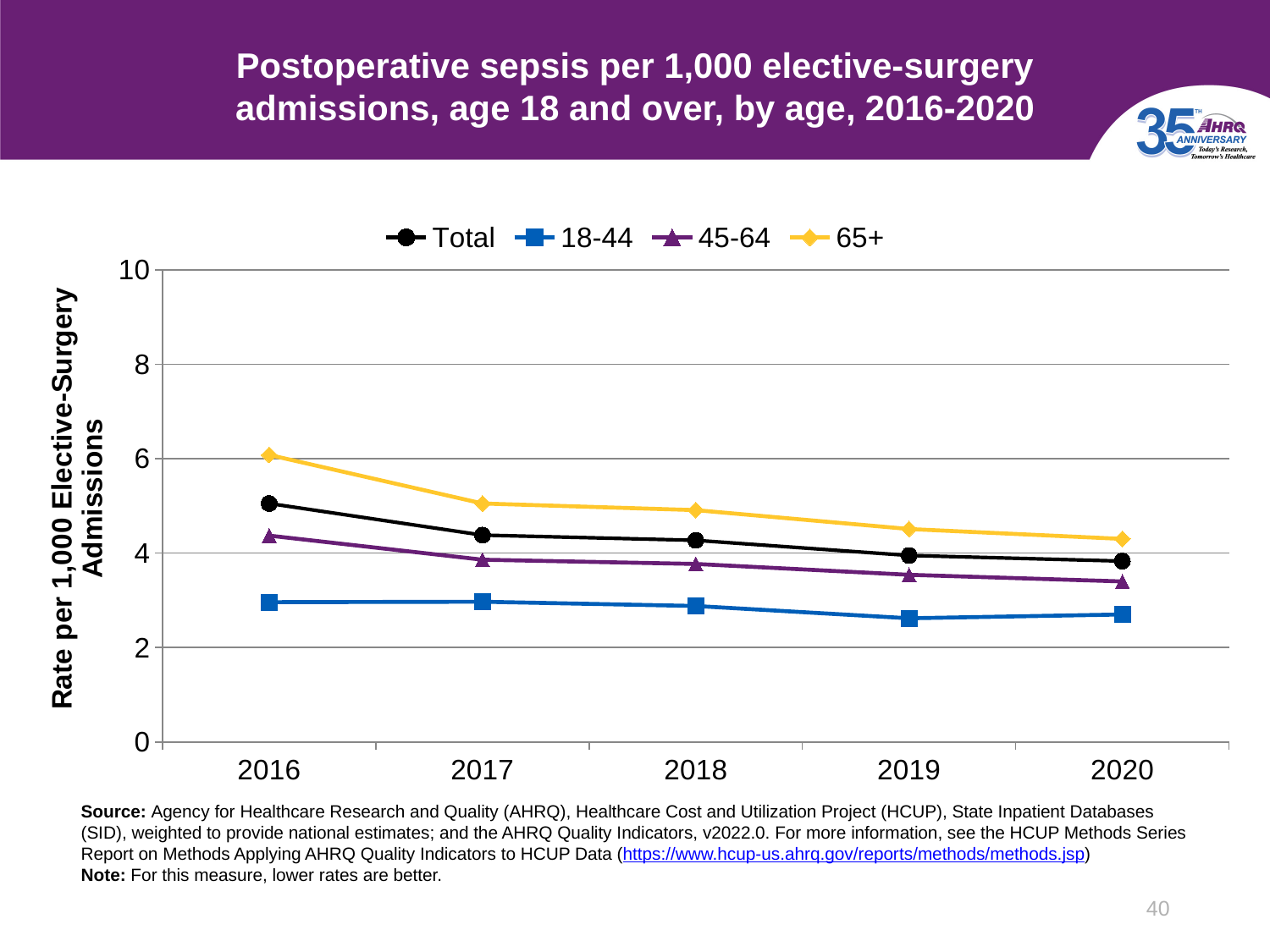
Does the rate for the 65+ group rise or fall from 2016 to 2020? fall How many years are plotted along the x axis? 5 Is the value for the 65+ group in 2017 greater or less than 4? greater What kind of chart is shown on the slide? line chart Which series is drawn in yellow with diamond markers? 65+ Which age group has the highest rate in 2016? 65+ Which is larger in 2018, the rate for the 45-64 group or the rate for the 18-44 group? 45-64 Is the value for the Total series in 2016 greater or less than 4? greater Which age group has the lowest rate in 2020? 18-44 What is the label on the y axis? Rate per 1,000 Elective-Surgery Admissions How many series does the legend list? 4 Is the value for the 18-44 group in 2019 greater or less than 4? less